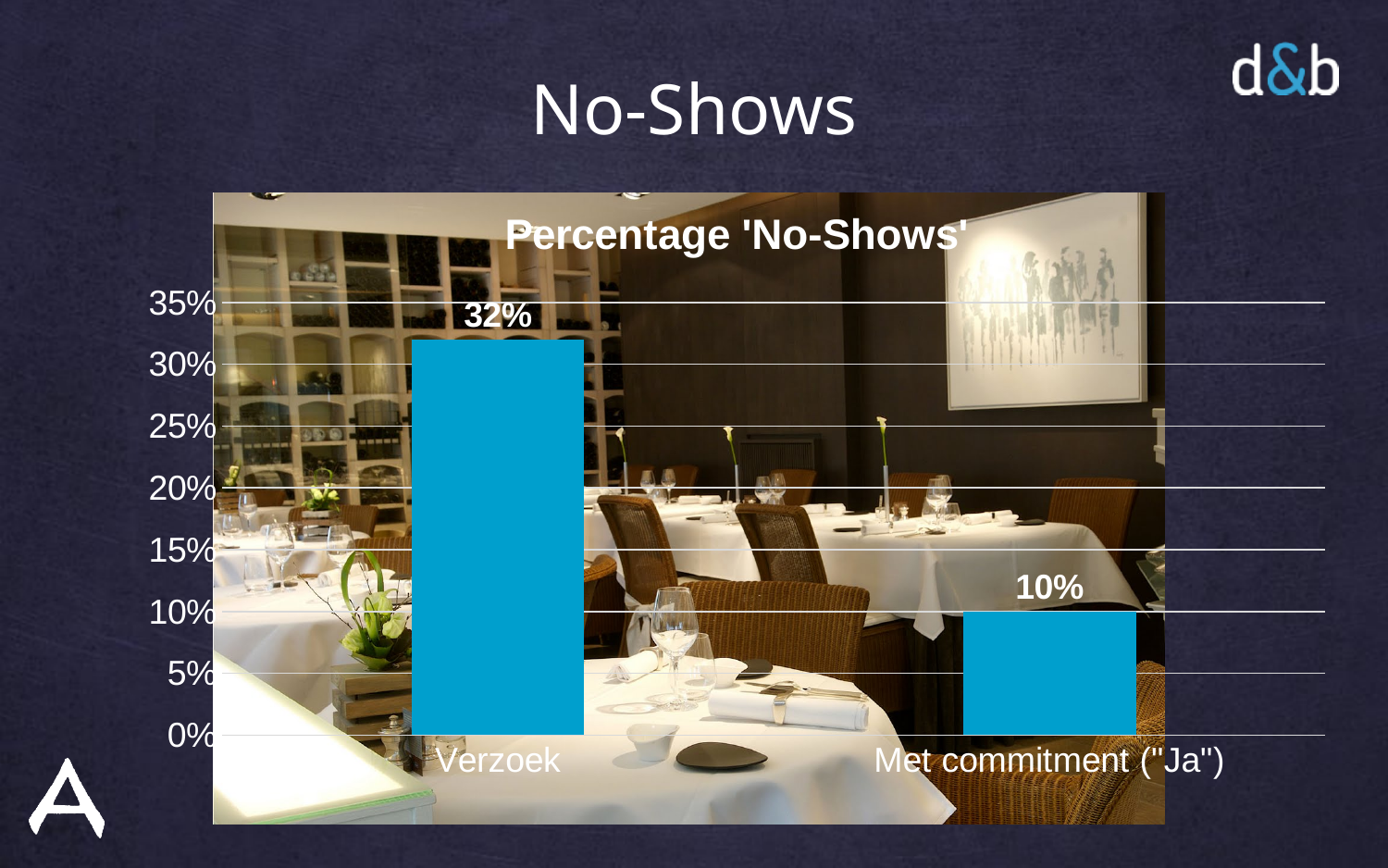
Which has a higher no-show percentage, 'Verzoek' or 'Met commitment ("Ja")'? Verzoek Is the value for 'Met commitment ("Ja")' greater or less than 15%? less What is the percentage of no-shows for 'Met commitment ("Ja")'? 10% What is the title of the chart? Percentage 'No-Shows' What is the percentage of no-shows for 'Verzoek'? 32% What is the highest value shown on the vertical axis? 35% What is the difference in no-show percentage between 'Verzoek' and 'Met commitment ("Ja")'? 22% Is the value for 'Verzoek' greater or less than 30%? greater Which category has the lowest percentage of no-shows? Met commitment ("Ja") What kind of chart is shown on the slide? Bar chart How many categories are shown in the chart? 2 Which category has the highest percentage of no-shows? Verzoek